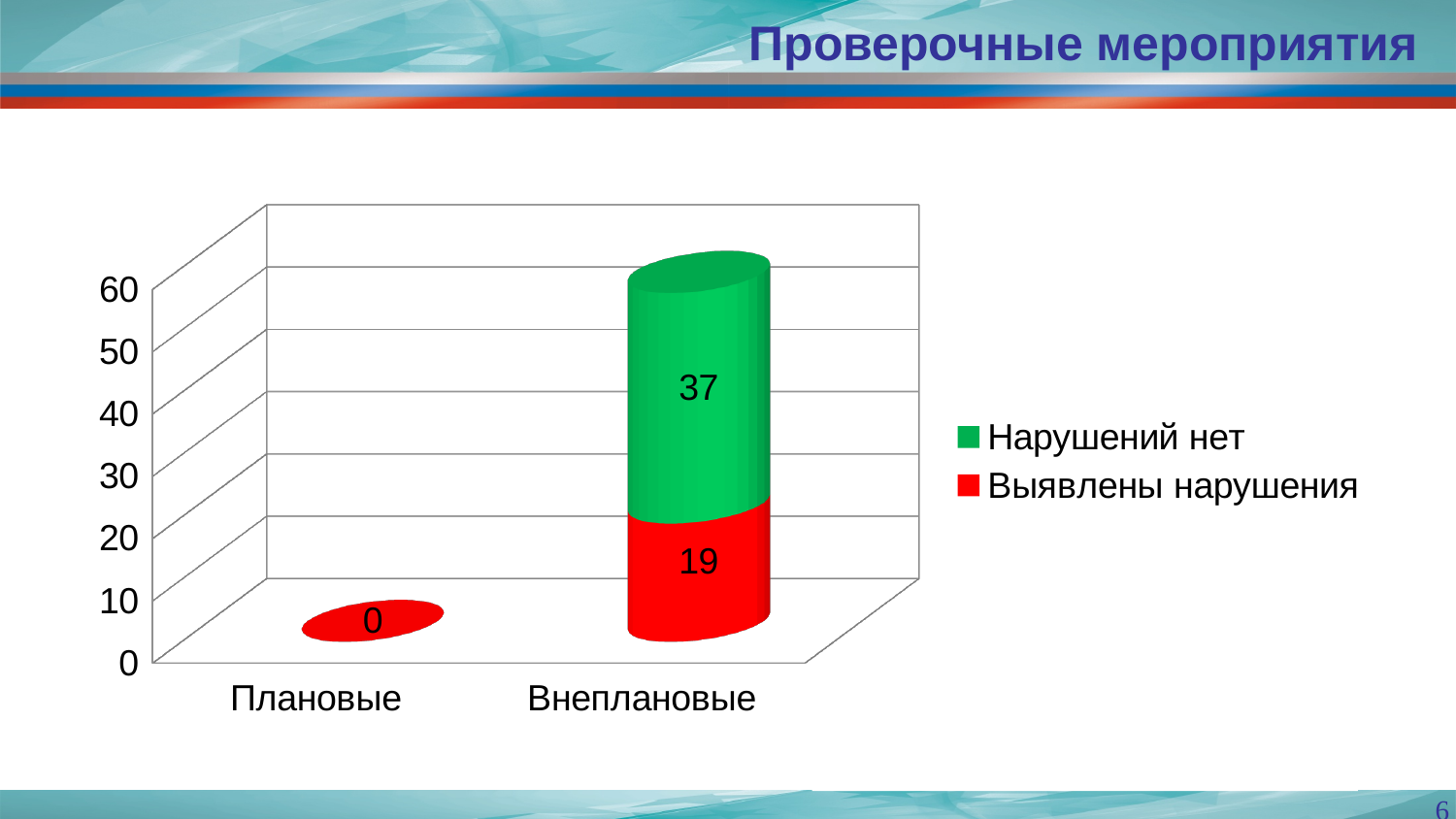
What is the value for "Нарушений нет" in the "Внеплановые" category? 37 How many categories are shown on the x axis? 2 What is the difference between "Нарушений нет" and "Выявлены нарушения" for "Внеплановые"? 18 Which category has the highest total? Внеплановые What is the total of the stacked bar for "Внеплановые"? 56 For "Внеплановые", which is larger: "Нарушений нет" or "Выявлены нарушения"? Нарушений нет Which colour represents "Выявлены нарушения" in the legend? Red What value is labelled on the bar for the "Плановые" category? 0 What kind of chart is shown on the slide? Stacked bar chart What is the value for "Выявлены нарушения" in the "Внеплановые" category? 19 Which category has the lowest total? Плановые How many series does the legend list? 2